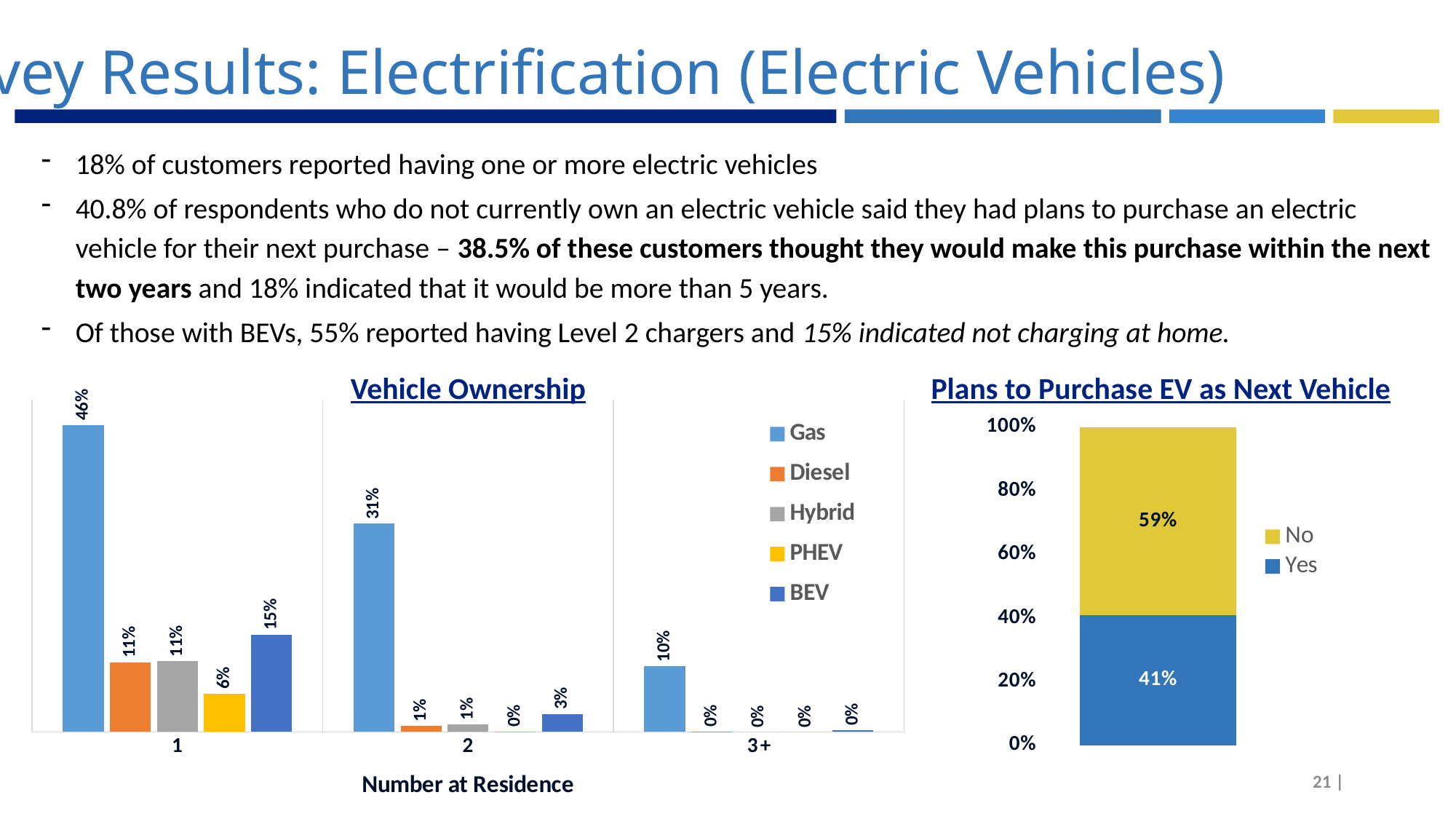
What kind of chart is the Plans to Purchase EV as Next Vehicle chart? stacked bar chart In the Vehicle Ownership chart, does the Gas value fall or rise as the number at residence increases from 1 to 3+? fall In the Plans to Purchase EV as Next Vehicle chart, what is the difference between No and Yes? 18% In the Vehicle Ownership chart, what is the difference between Gas and BEV at 1 vehicle at residence? 31% In the Vehicle Ownership chart, which series has the highest value at 3+ vehicles at residence? Gas In the Plans to Purchase EV as Next Vehicle chart, what is the value for Yes? 41% In the Vehicle Ownership chart, what is the value for BEV at 1 vehicle at residence? 15% In the Vehicle Ownership chart, what is the value for Gas at 2 vehicles at residence? 31% In the Vehicle Ownership chart, what is the value for PHEV at 1 vehicle at residence? 6% How many series does the legend of the Vehicle Ownership chart list? 5 In the Vehicle Ownership chart, which is larger at 1 vehicle at residence: BEV or PHEV? BEV In the Vehicle Ownership chart, what is the value for Gas at 1 vehicle at residence? 46%